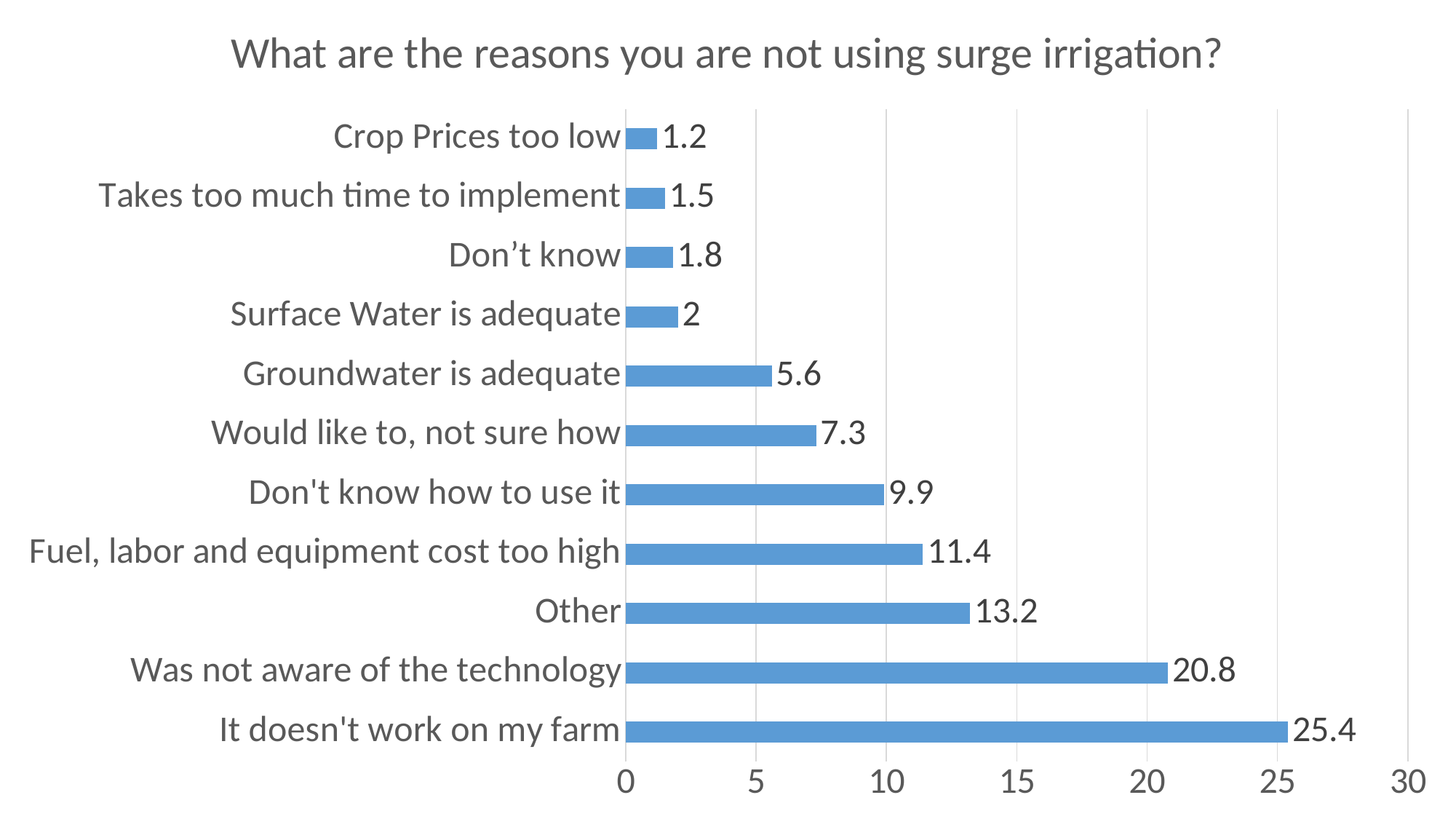
What is the title of the chart? What are the reasons you are not using surge irrigation? What is the value for "Other"? 13.2 What is the value for "Was not aware of the technology"? 20.8 Is the value for "Other" greater or less than 10? greater Which reason has the lowest value? Crop Prices too low Which is larger, the value for "Would like to, not sure how" or the value for "Groundwater is adequate"? Would like to, not sure how What kind of chart is shown on the slide? Bar chart How many reasons (categories) are shown in the chart? 11 What is the value for "Groundwater is adequate"? 5.6 What is the difference between the values for "It doesn't work on my farm" and "Was not aware of the technology"? 4.6 What is the difference between the values for "Fuel, labor and equipment cost too high" and "Don't know how to use it"? 1.5 Which reason has the highest value? It doesn't work on my farm